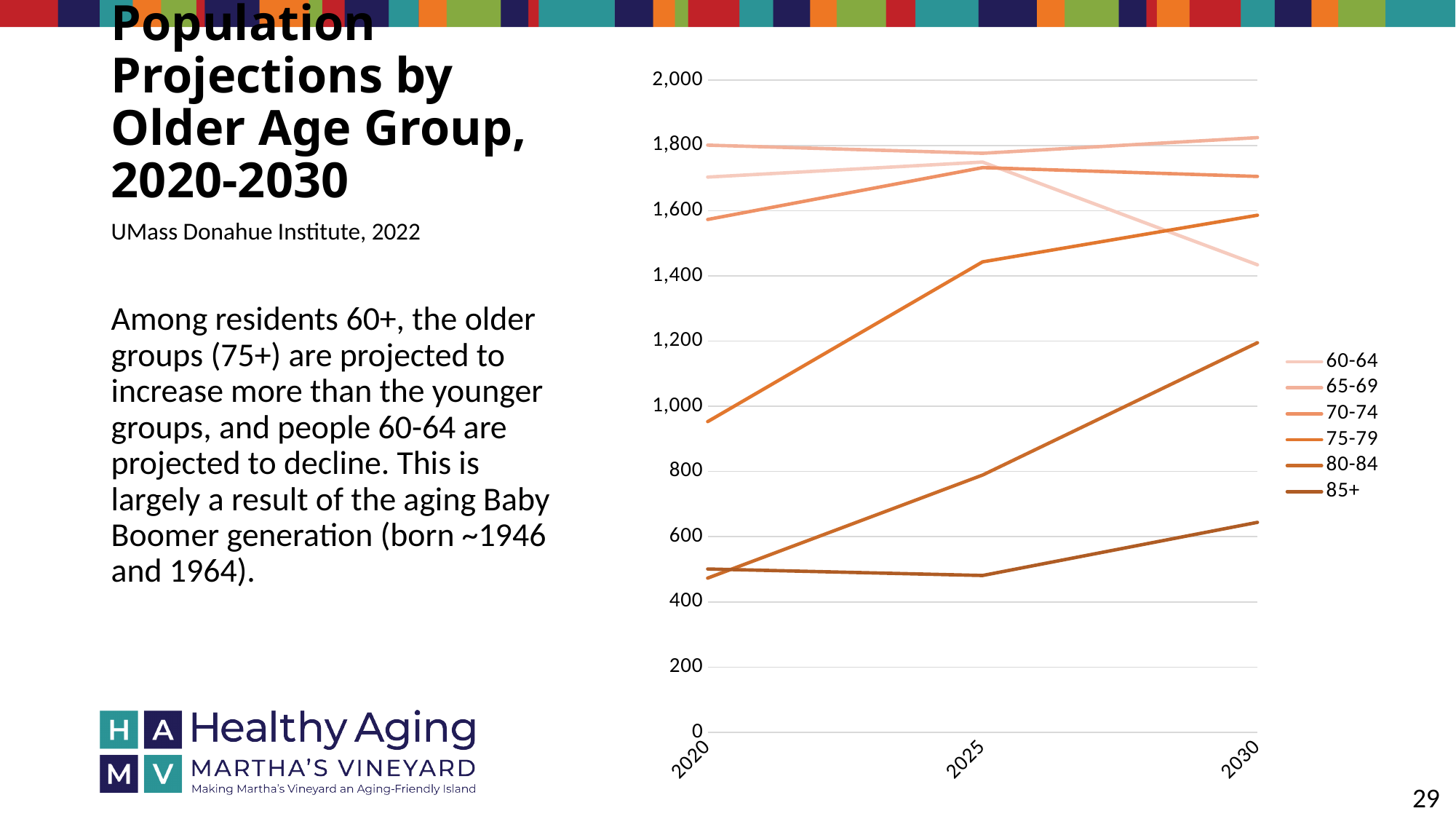
Is the value for the 75-79 group in 2020 greater or less than 1,000? less What is the title of the chart on the slide? Population Projections by Older Age Group, 2020-2030 Is the value for the 80-84 group in 2030 greater or less than 1,000? greater In 2030, which is larger: the value for 80-84 or the value for 85+? 80-84 Is the value for the 60-64 group in 2030 greater or less than 1,600? less What kind of chart is shown on the slide? line chart Which age group has the highest value in 2030? 65-69 Which age group has the lowest value in 2030? 85+ Does the 60-64 line rise or fall from 2025 to 2030? fall How many series does the legend list? 6 How many years are shown on the x axis? 3 Does the 80-84 line rise or fall from 2020 to 2030? rise